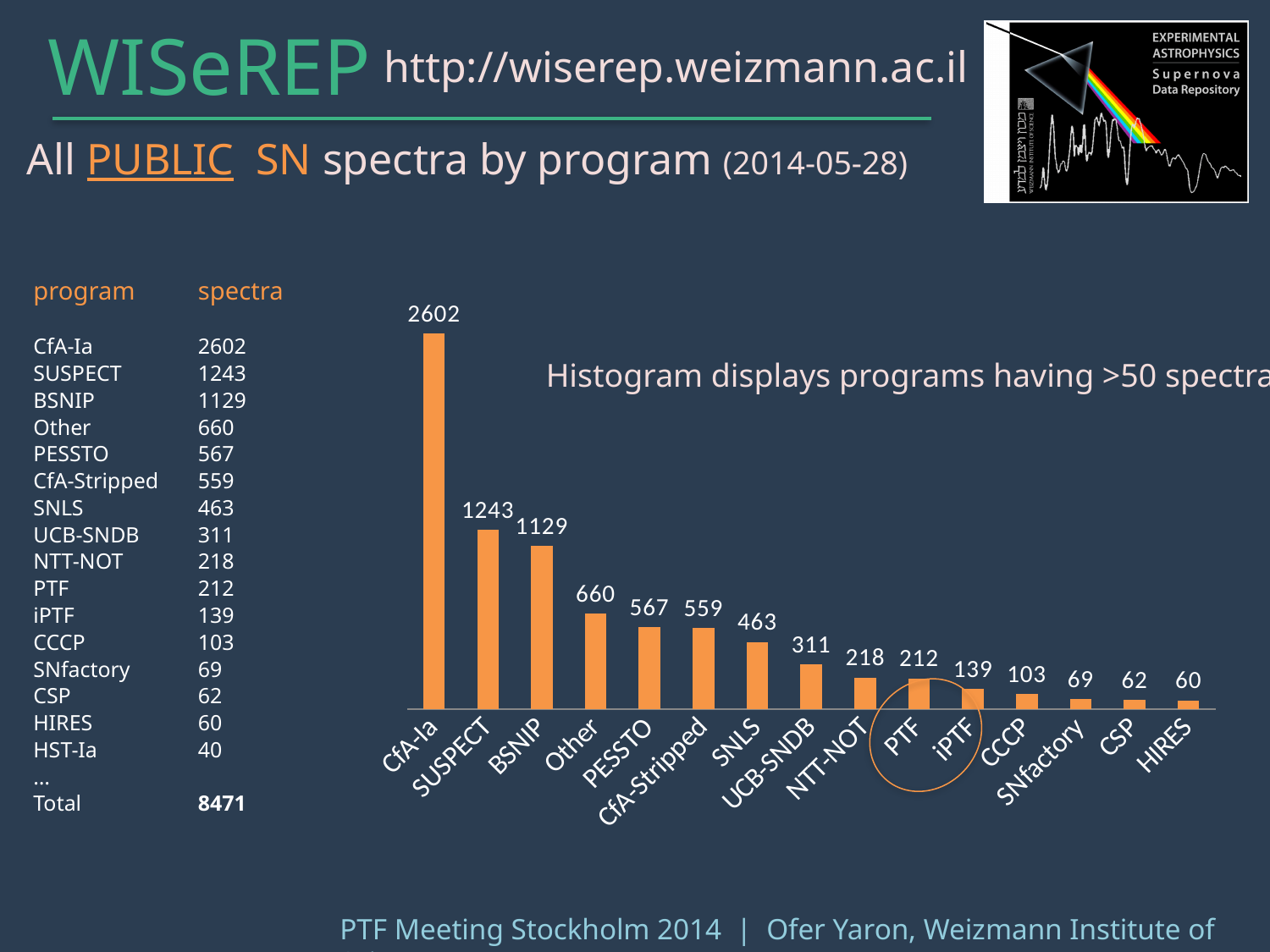
What is the number of spectra for PESSTO in the chart? 567 What is the difference in spectra between SUSPECT and BSNIP? 114 What is the number of spectra for iPTF in the chart? 139 Do the bar values rise or fall from left to right along the x axis? fall Which has more spectra, SNLS or UCB-SNDB? SNLS Which program has the lowest number of spectra in the chart? HIRES Which two bars are circled in the chart? PTF and iPTF What is the number of spectra for CfA-Ia in the chart? 2602 What kind of chart is shown on the slide? bar chart How many programs are shown as bars in the chart? 15 Which program has the highest number of spectra in the chart? CfA-Ia What is the difference in spectra between PTF and iPTF? 73